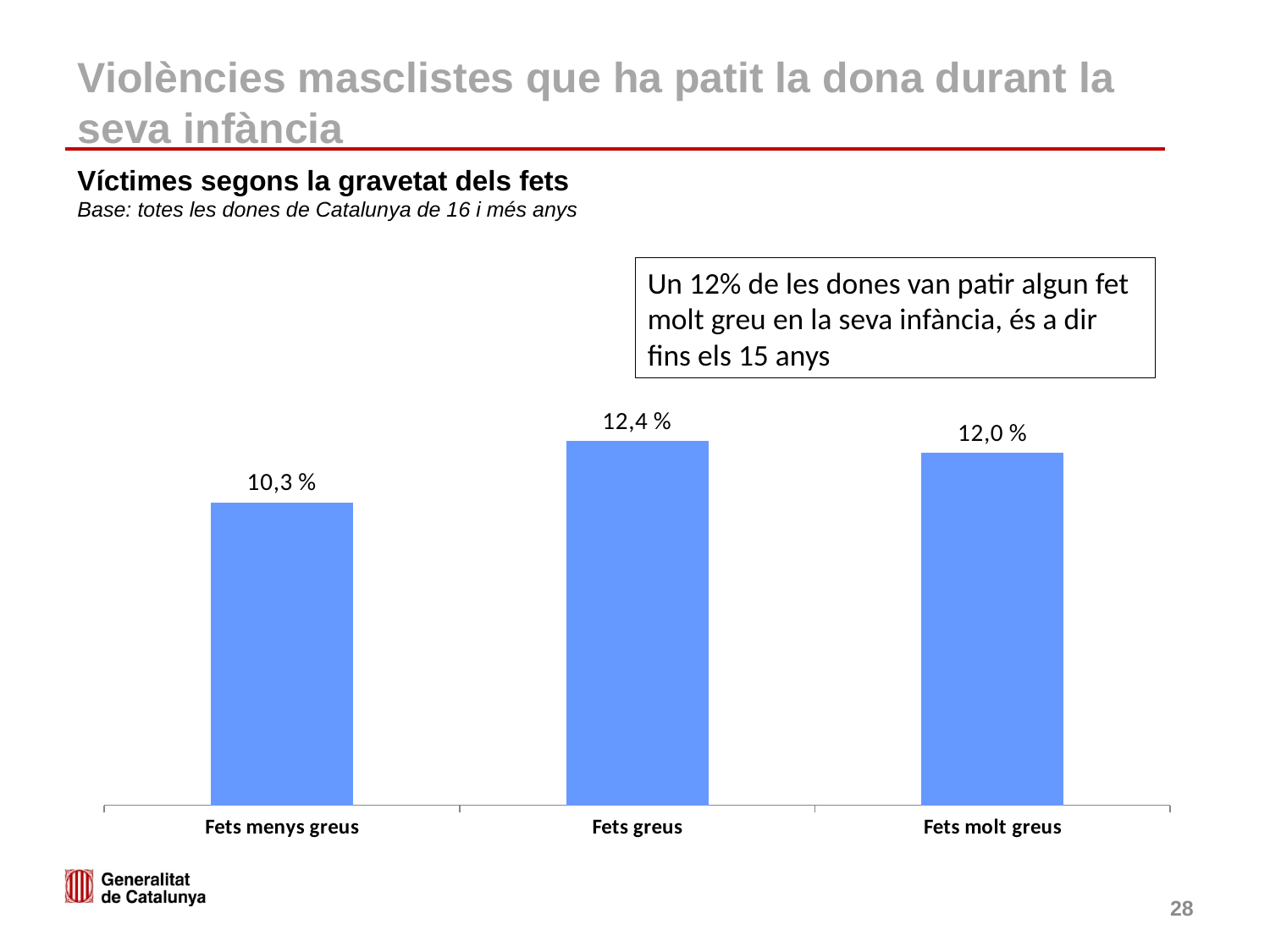
What is the title of the chart? Víctimes segons la gravetat dels fets What is the value for Fets menys greus? 10,3 % What is the difference between the values for Fets greus and Fets molt greus? 0,4 % What is the value for Fets greus? 12,4 % How many categories are shown in the chart? 3 What kind of chart is shown on the slide? Bar chart Which is larger, the value for Fets greus or the value for Fets molt greus? Fets greus What is the difference between the values for Fets greus and Fets menys greus? 2,1 % Which is larger, the value for Fets menys greus or the value for Fets molt greus? Fets molt greus Which category has the highest value? Fets greus Which category has the lowest value? Fets menys greus What is the value for Fets molt greus? 12,0 %